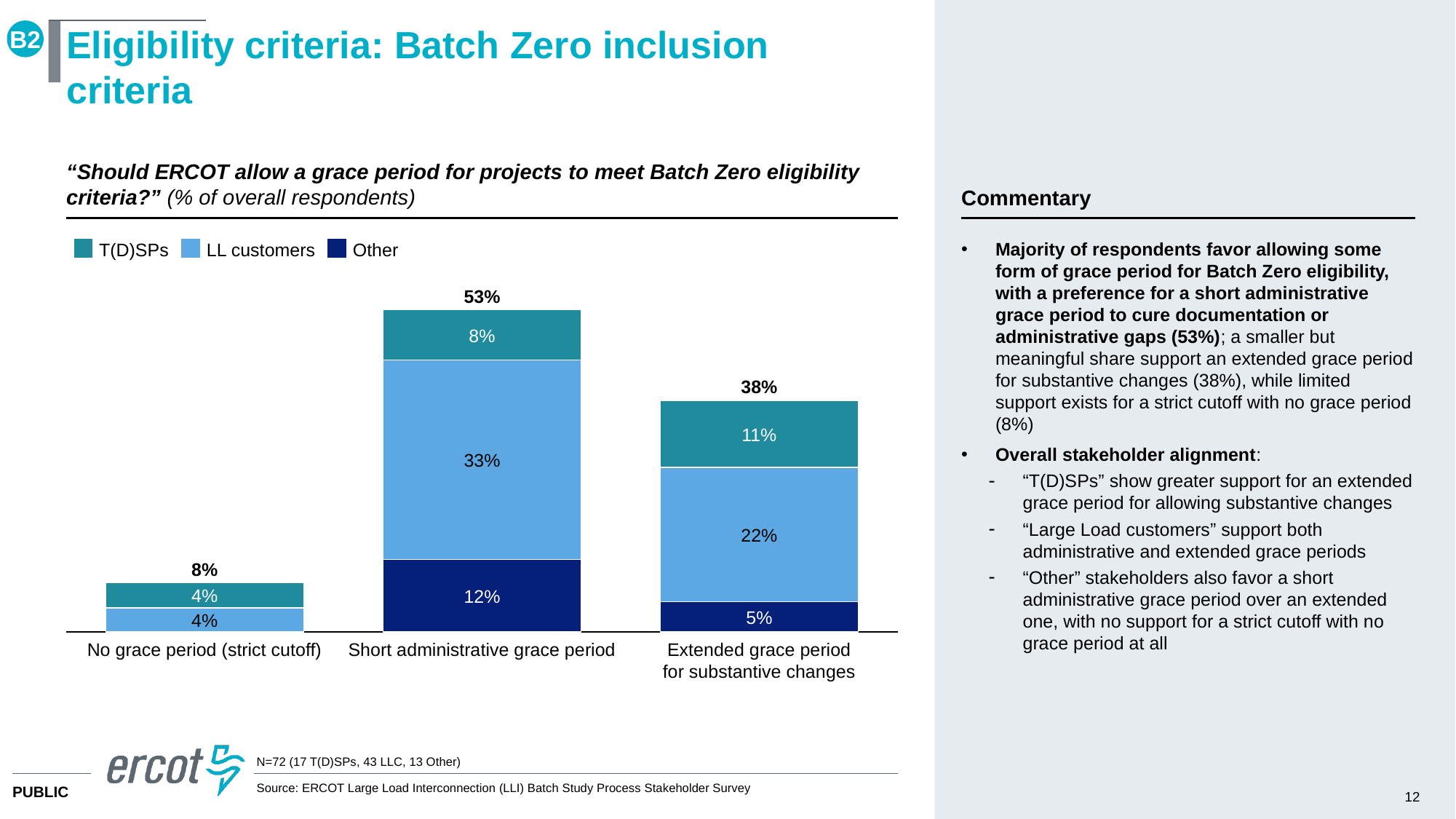
What kind of chart is shown? Stacked bar chart Which is larger: the T(D)SPs value for 'Short administrative grace period' or for 'Extended grace period for substantive changes'? Extended grace period for substantive changes What is the T(D)SPs value for 'No grace period (strict cutoff)'? 4% What is the Other value for 'Short administrative grace period'? 12% Which category has the highest total? Short administrative grace period What is the LL customers value for 'Extended grace period for substantive changes'? 22% What is the total for the 'Short administrative grace period' bar? 53% Which category has the lowest total? No grace period (strict cutoff) How many series does the legend list? 3 What is the difference between the totals for 'Short administrative grace period' and 'Extended grace period for substantive changes'? 15% How many categories are shown on the x axis? 3 Which series is shown in the darkest blue colour in the legend? Other